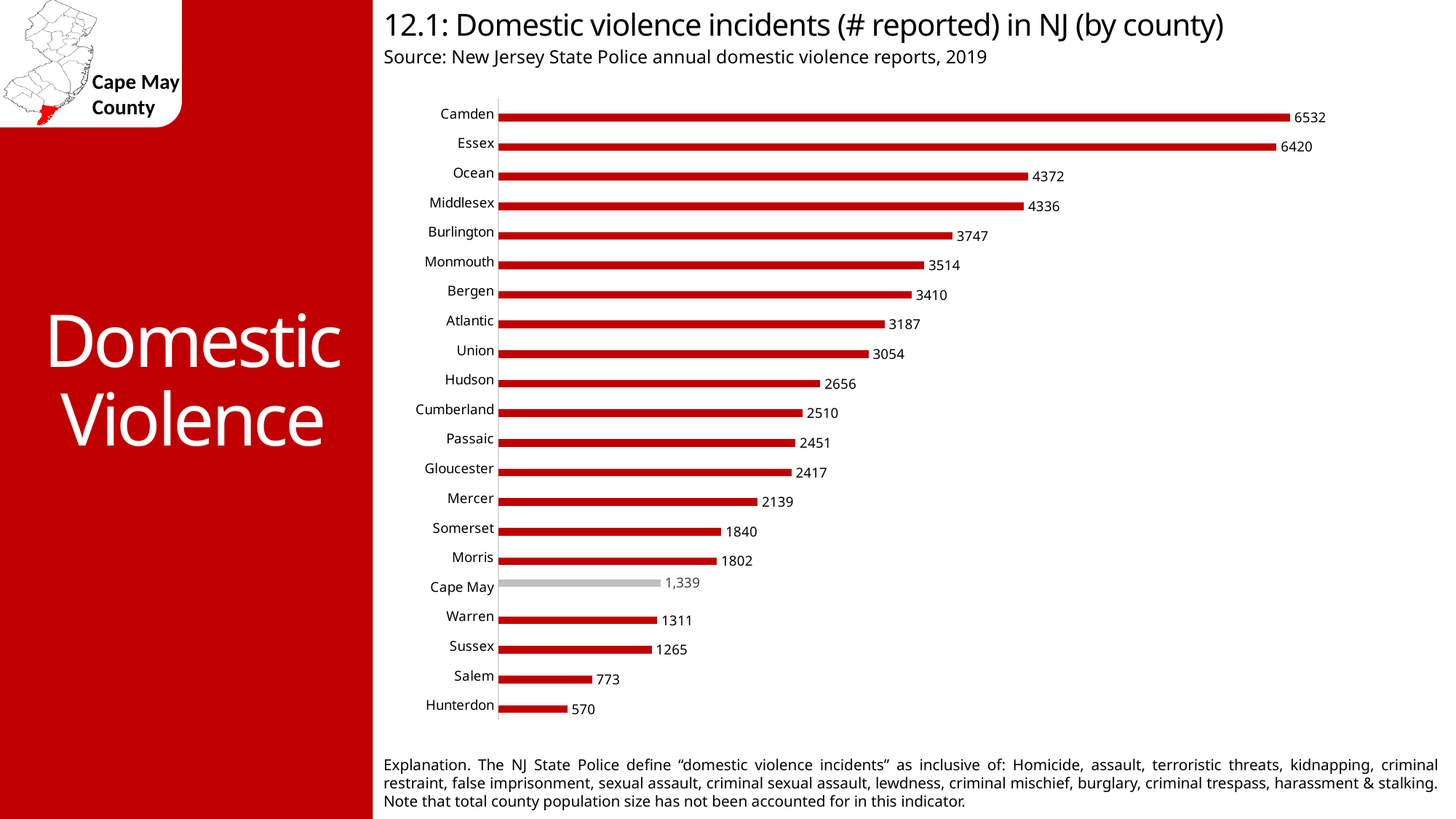
How many counties are shown in the chart? 21 What is the difference between the number of incidents in Camden and Essex? 112 Which county's bar is shown in grey instead of red? Cape May What is the number of domestic violence incidents reported for Camden? 6532 Which county has more reported incidents, Cape May or Warren? Cape May Which county has the highest number of reported domestic violence incidents? Camden What is the difference between the number of incidents in Salem and Hunterdon? 203 Which county has more reported incidents, Burlington or Monmouth? Burlington What kind of chart is used to show domestic violence incidents by county? Bar chart Which county has the lowest number of reported domestic violence incidents? Hunterdon What is the number of domestic violence incidents reported for Hunterdon? 570 What is the number of domestic violence incidents reported for Cape May? 1,339